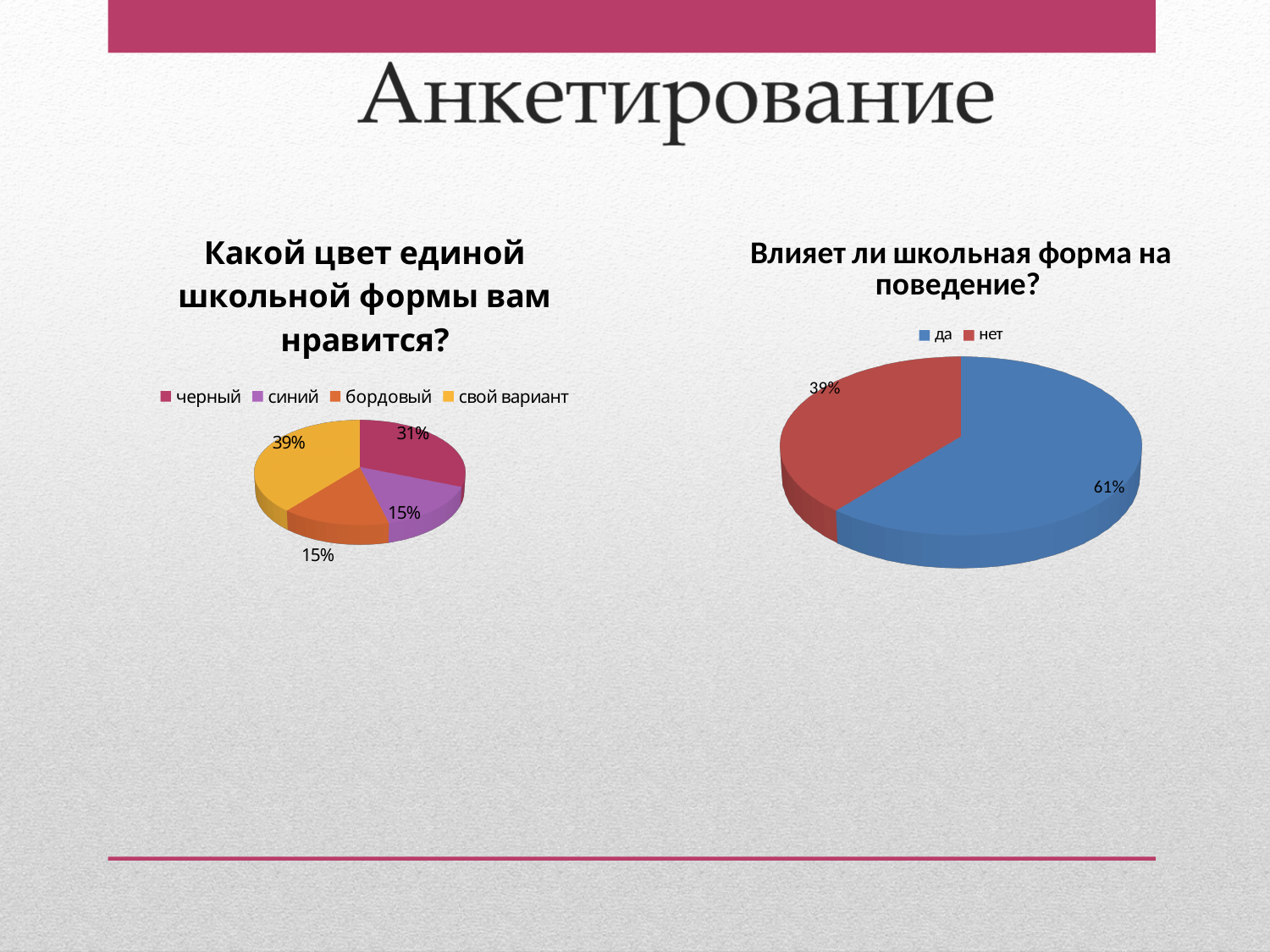
In the right chart 'Влияет ли школьная форма на поведение?', which answer has the smaller slice? нет In the left chart 'Какой цвет единой школьной формы вам нравится?', what is the difference between the shares of 'свой вариант' and 'черный'? 8% What type of chart is the right chart 'Влияет ли школьная форма на поведение?'? pie chart In the right chart 'Влияет ли школьная форма на поведение?', what share does 'да' have? 61% In the right chart 'Влияет ли школьная форма на поведение?', what is the difference between the shares of 'да' and 'нет'? 22% In the left chart 'Какой цвет единой школьной формы вам нравится?', what share does 'черный' have? 31% In the left chart 'Какой цвет единой школьной формы вам нравится?', how many categories does the legend list? 4 In the left chart 'Какой цвет единой школьной формы вам нравится?', which category has the largest slice? свой вариант In the left chart 'Какой цвет единой школьной формы вам нравится?', what share does 'синий' have? 15% In the left chart 'Какой цвет единой школьной формы вам нравится?', which is larger: 'черный' or 'бордовый'? черный